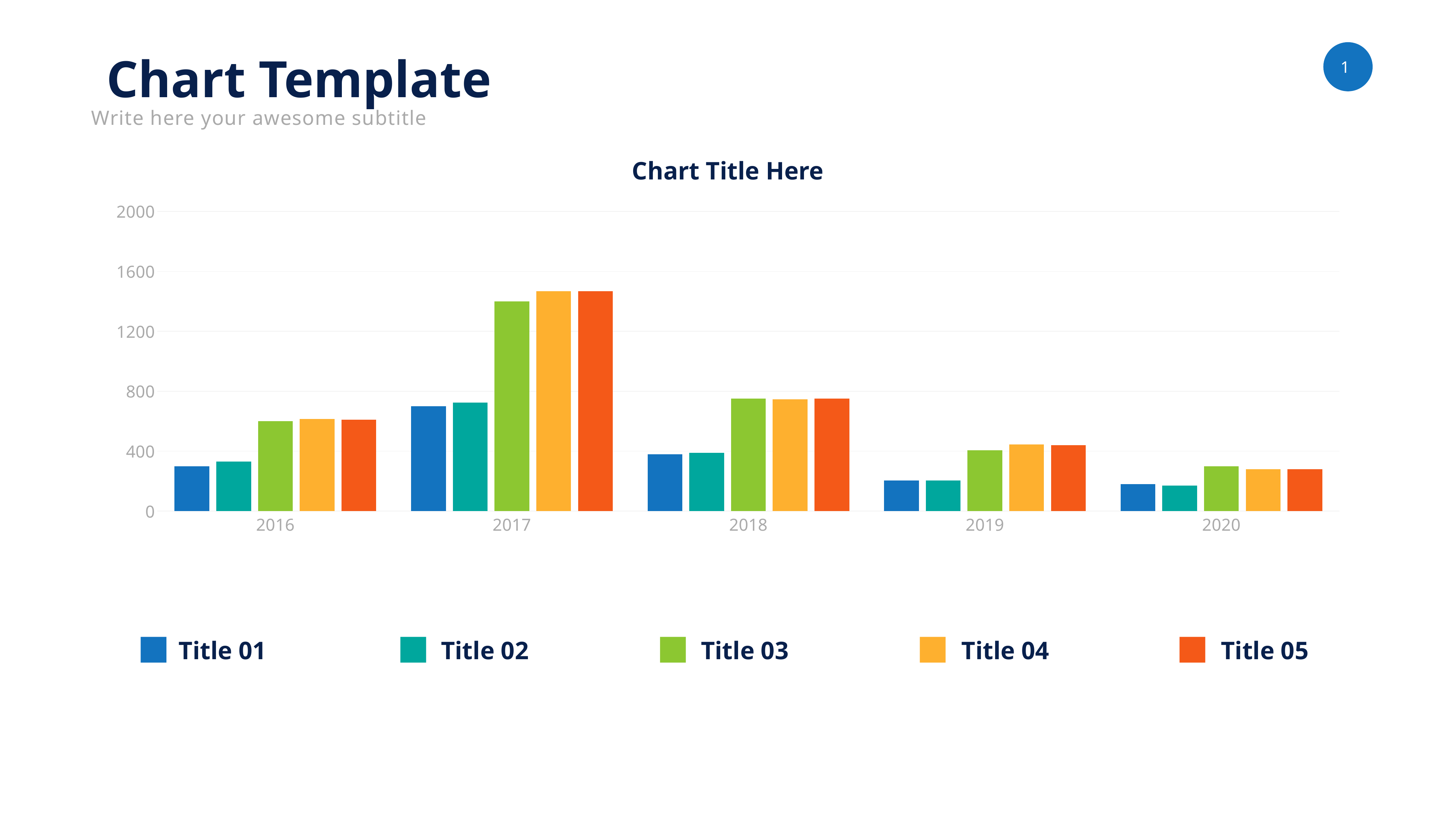
What is the title of the chart? Chart Title Here How many years are shown on the x axis of the chart? 5 Is the value for Title 01 in 2017 greater or less than 800? less In which year is the value for Title 03 the lowest? 2020 Which is larger: the value for Title 05 in 2017 or the value for Title 05 in 2018? Title 05 in 2017 Do the values for Title 04 rise or fall from 2017 to 2020? fall How many series does the chart's legend list? 5 In which year is the value for Title 03 the highest? 2017 Is the value for Title 01 in 2016 greater or less than 400? less What kind of chart is shown on the slide? bar chart Is the value for Title 03 in 2017 greater or less than 1200? greater